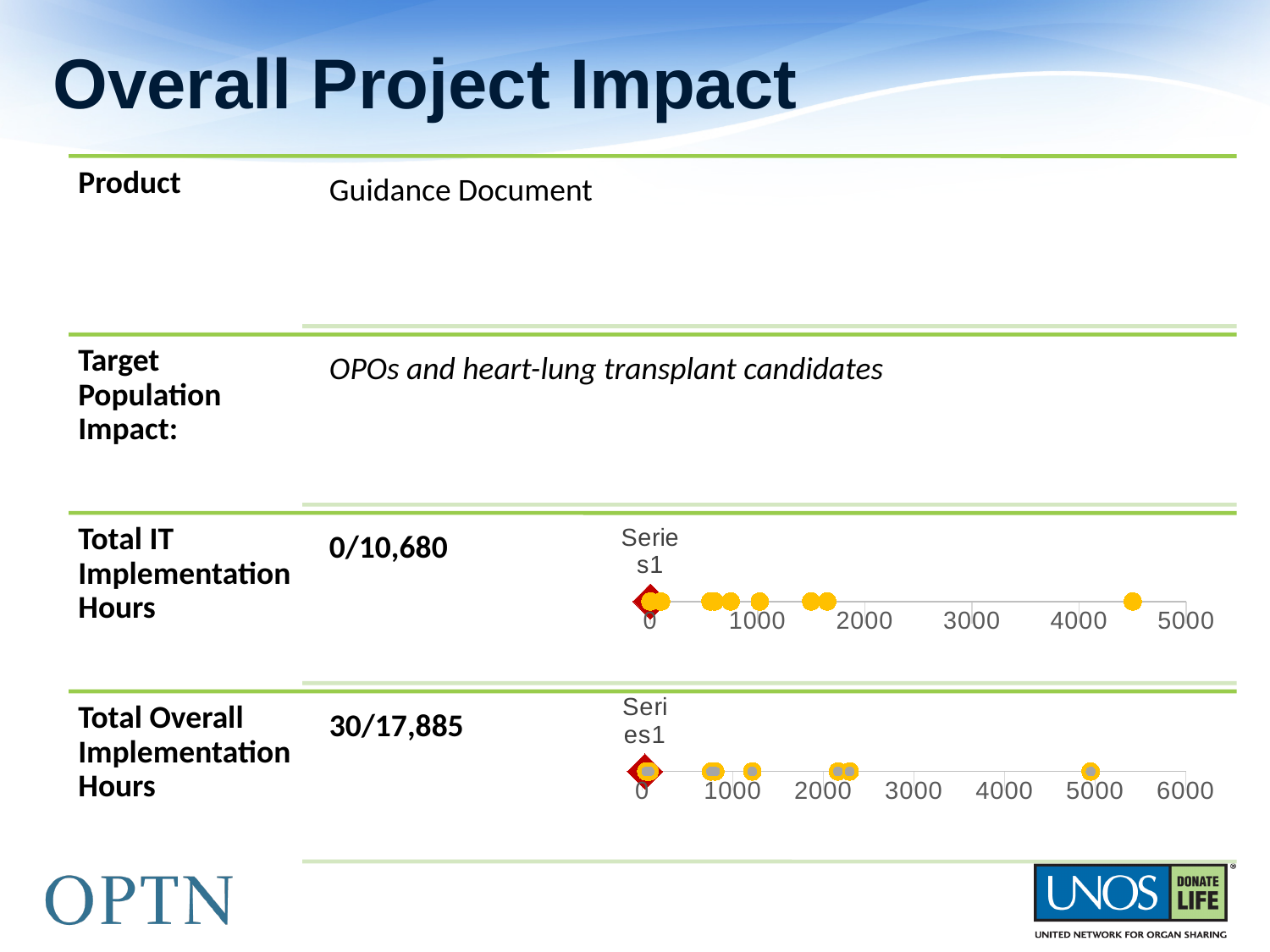
In the chart next to "Total Overall Implementation Hours", is the rightmost point greater or less than 4000? greater Which chart has the larger maximum axis tick value, the one next to "Total IT Implementation Hours" or the one next to "Total Overall Implementation Hours"? Total Overall Implementation Hours In the chart next to "Total Overall Implementation Hours", is the rightmost point greater or less than 6000? less How many series does the legend of the chart next to "Total IT Implementation Hours" list? 1 What is the legend entry shown on the chart next to "Total IT Implementation Hours"? Series1 In the chart next to "Total IT Implementation Hours", is the rightmost point greater or less than 5000? less What kind of chart is shown next to "Total IT Implementation Hours"? Scatter chart What is the highest axis tick value on the chart next to "Total IT Implementation Hours"? 5000 How many series does the legend of the chart next to "Total Overall Implementation Hours" list? 1 What kind of chart is shown next to "Total Overall Implementation Hours"? Scatter chart